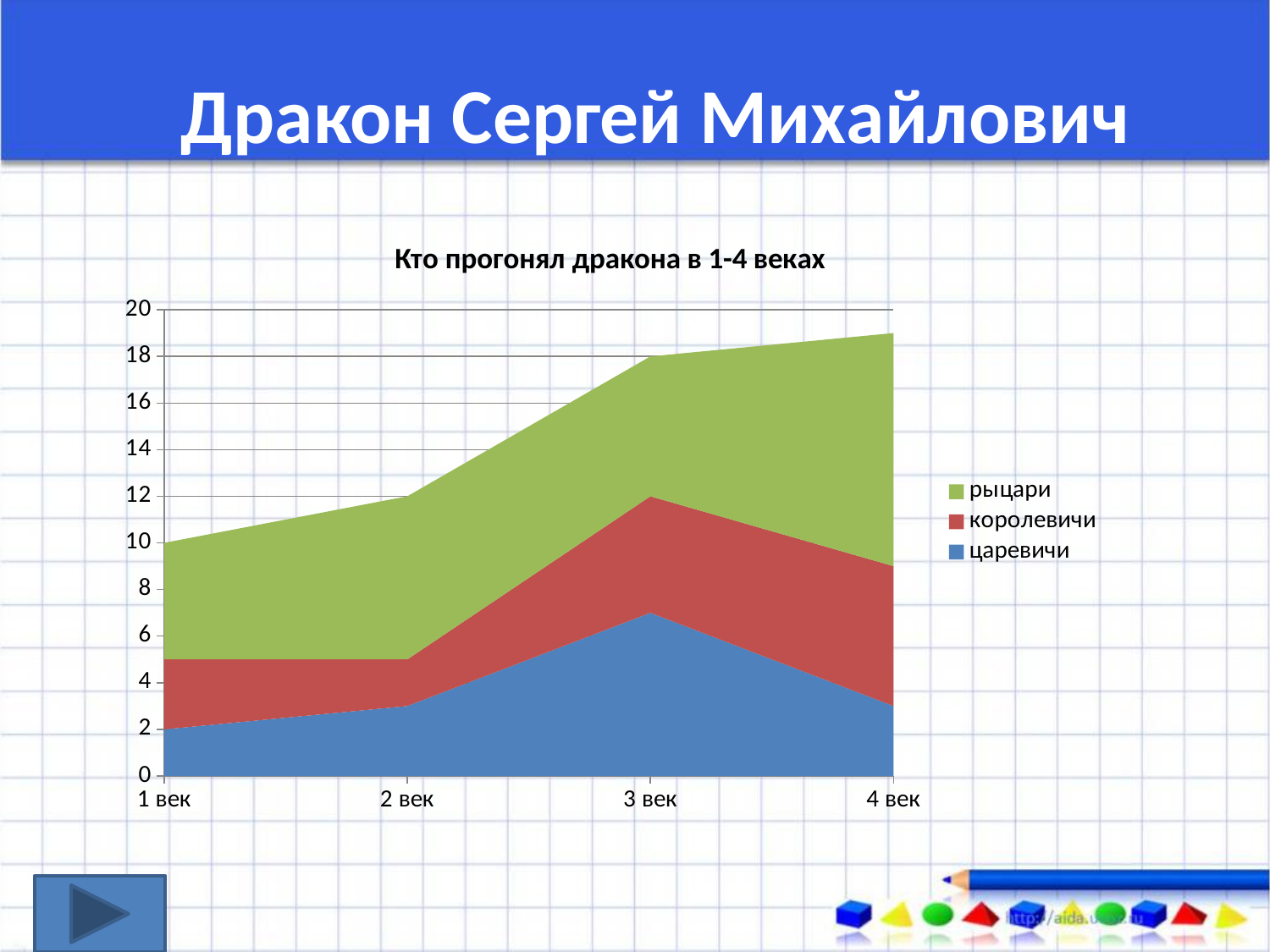
Does the total of all series rise or fall from 1 век to 3 век? rises Is the total of all three series in 4 век greater or less than 18? greater In which century is the value for царевичи the highest? 3 век What is the value for царевичи in 1 век? 2 What is the total of all three series in 1 век? 10 How many series does the legend list? 3 Which is larger: the value for царевичи in 3 век or in 2 век? 3 век How many categories (centuries) are shown on the x axis? 4 What is the title of the chart? Кто прогонял дракона в 1-4 веках What is the total of all three series in 3 век? 18 What kind of chart is shown on the slide? Stacked area chart